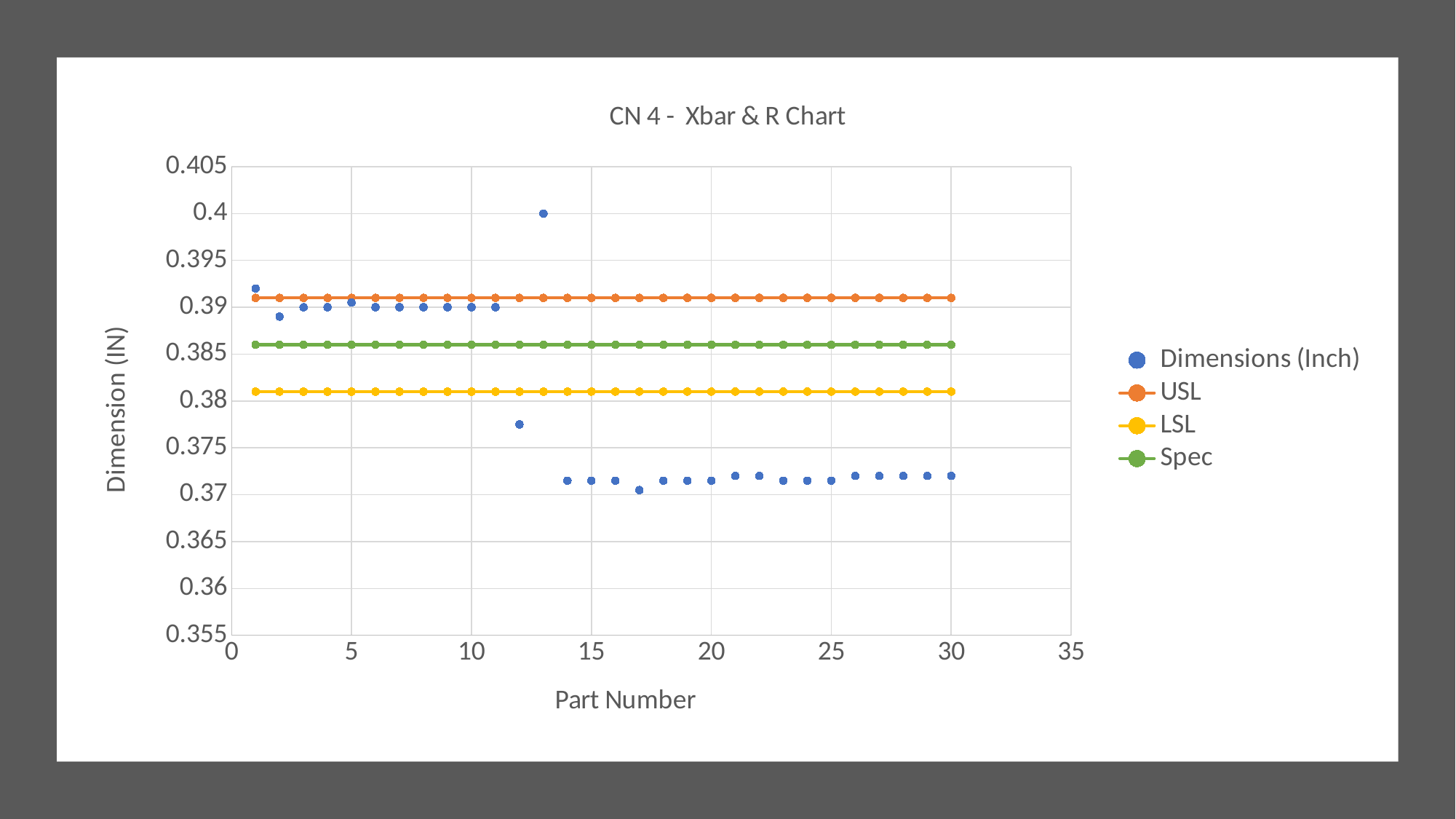
What is the label of the x axis? Part Number Which part number has the highest Dimensions (Inch) value? 13 Is the Dimensions (Inch) value for part number 13 greater or less than 0.395? greater Which has the larger Dimensions (Inch) value, part number 2 or part number 14? part number 2 Is the USL value greater or less than 0.385? greater How many series does the legend list? 4 Is the LSL value greater or less than 0.385? less Which line is higher on the chart, USL or LSL? USL Which part number has the lowest Dimensions (Inch) value? 17 What is the title of the chart? CN 4 - Xbar & R Chart What kind of chart is shown on the slide? scatter chart